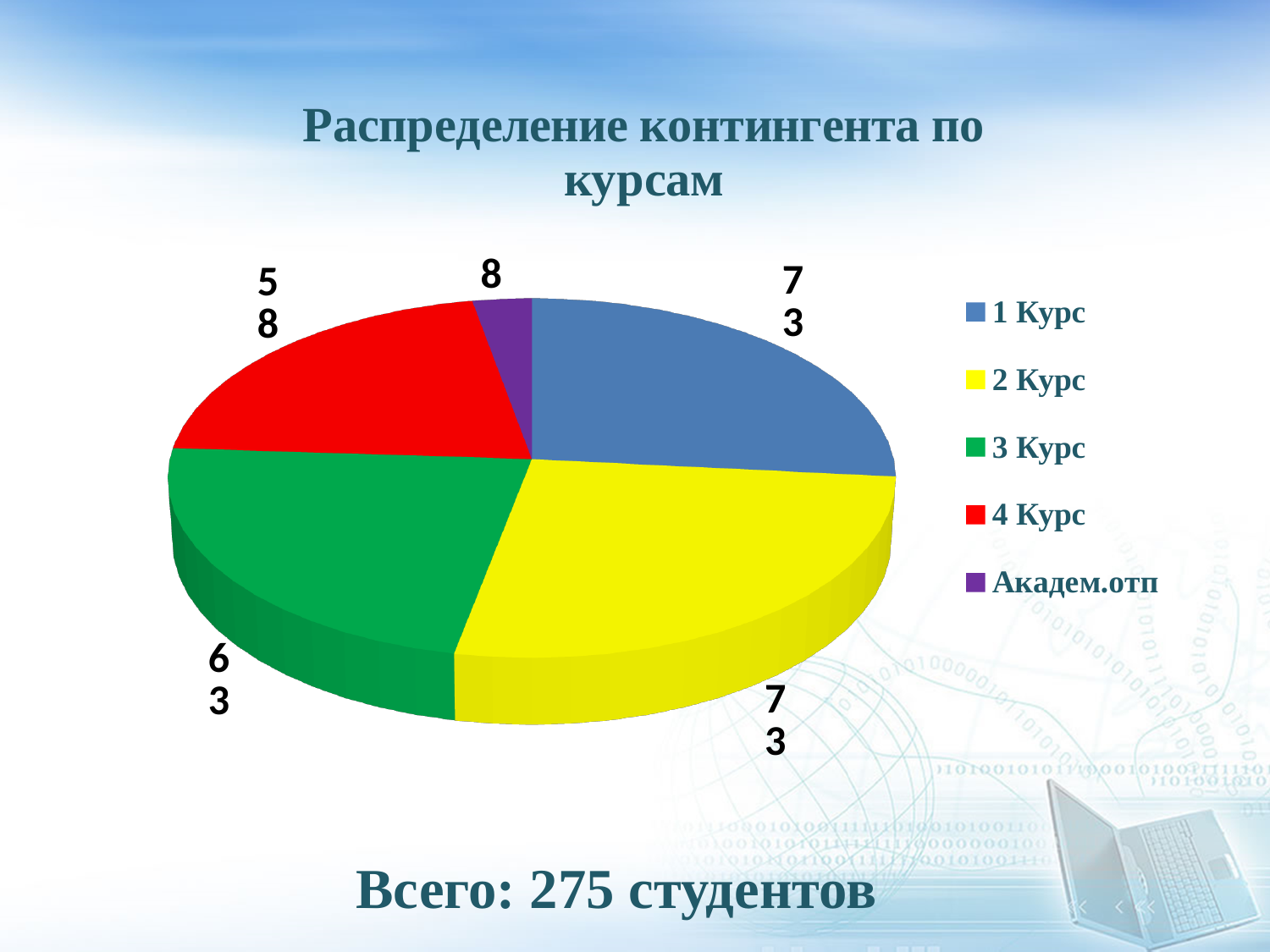
Which is larger, the value for 3 Курс or the value for 4 Курс? 3 Курс What is the value for Академ.отп? 8 What type of chart is shown on the slide? pie chart What colour represents 4 Курс in the chart? red What is the value for 2 Курс? 73 What is the value for 1 Курс? 73 How many categories does the pie chart have? 5 What is the value for 3 Курс? 63 Which category has the smallest slice? Академ.отп What is the difference between the values for 3 Курс and 4 Курс? 5 What is the value for 4 Курс? 58 What is the total number of students stated on the slide? 275